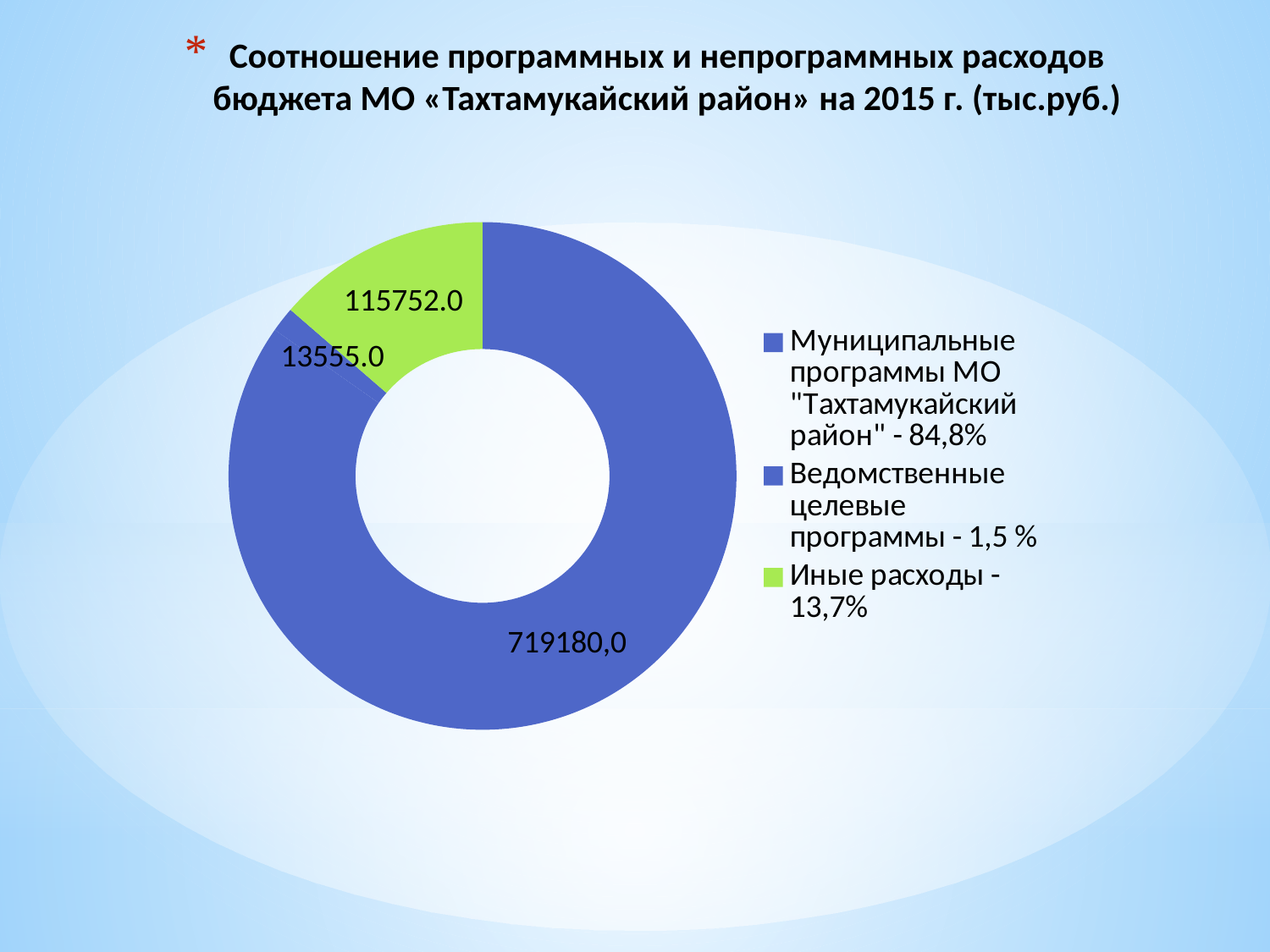
Which category has the smallest slice? Ведомственные целевые программы What value is shown for Ведомственные целевые программы? 13555.0 What is the difference between the values for Иные расходы and Ведомственные целевые программы? 102197.0 What share of the chart do Муниципальные программы МО "Тахтамукайский район" make up, according to the legend? 84,8% What value is shown for Муниципальные программы МО "Тахтамукайский район"? 719180,0 Which category has the largest slice? Муниципальные программы МО "Тахтамукайский район" How many categories does the chart show? 3 Which is larger: the value for Иные расходы or the value for Ведомственные целевые программы? Иные расходы What value is shown for Иные расходы? 115752.0 What kind of chart is shown on the slide? doughnut chart What colour is the slice for Иные расходы? green What share of the chart do Иные расходы make up, according to the legend? 13,7%